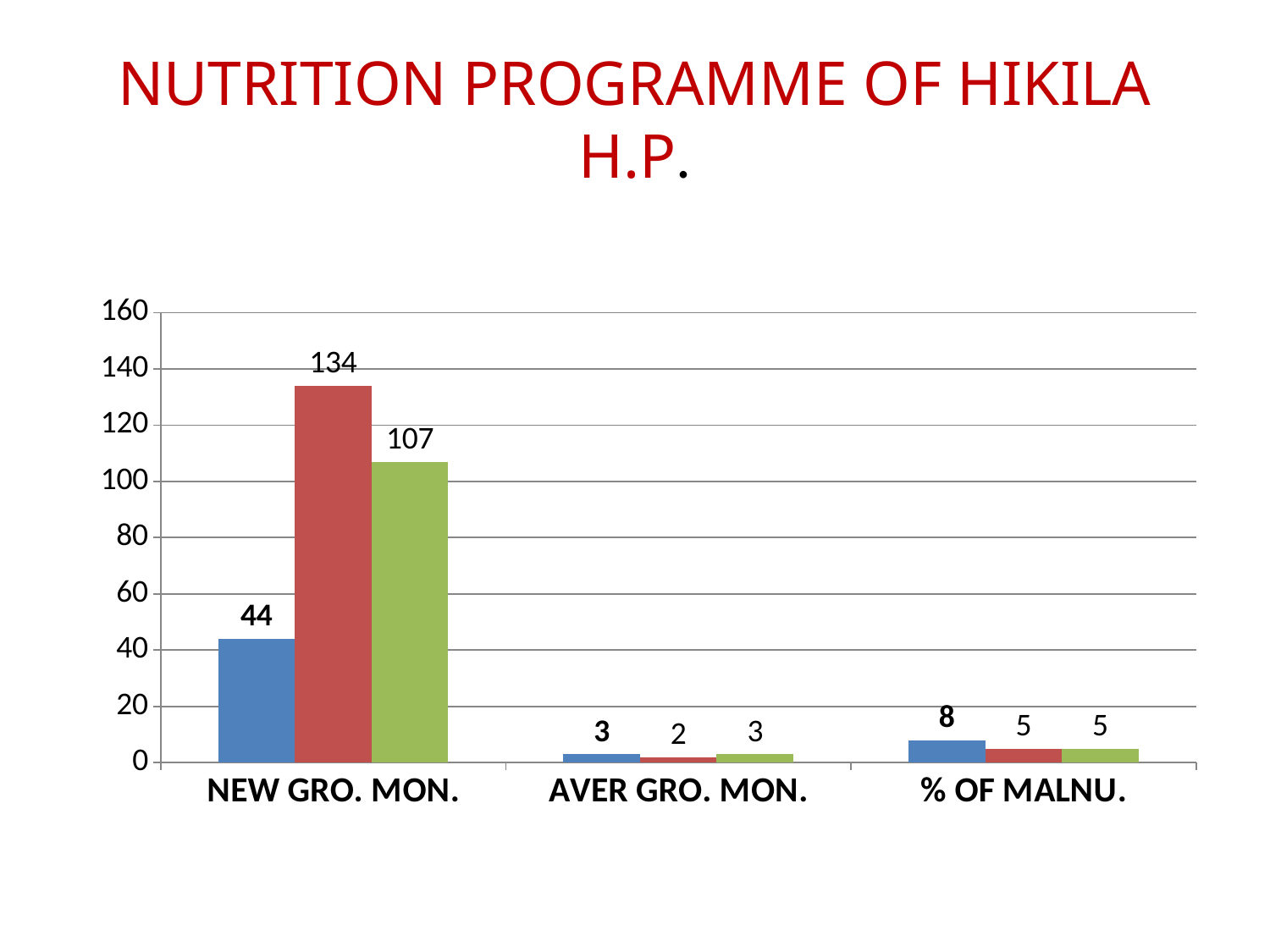
How many categories are shown on the x axis of the chart? 3 What is the value of the red bar for NEW GRO. MON.? 134 Which category has the tallest bar in the chart? NEW GRO. MON. What is the difference between the red bar and the green bar for NEW GRO. MON.? 27 What is the value of the red bar for AVER GRO. MON.? 2 What is the value of the blue bar for NEW GRO. MON.? 44 Is the value of the red bar for NEW GRO. MON. greater or less than 120? greater What is the difference between the red bar and the blue bar for NEW GRO. MON.? 90 What is the value of the blue bar for % OF MALNU.? 8 What is the value of the green bar for NEW GRO. MON.? 107 What kind of chart is shown on the slide? bar chart Which is larger for NEW GRO. MON., the blue bar or the green bar? the green bar